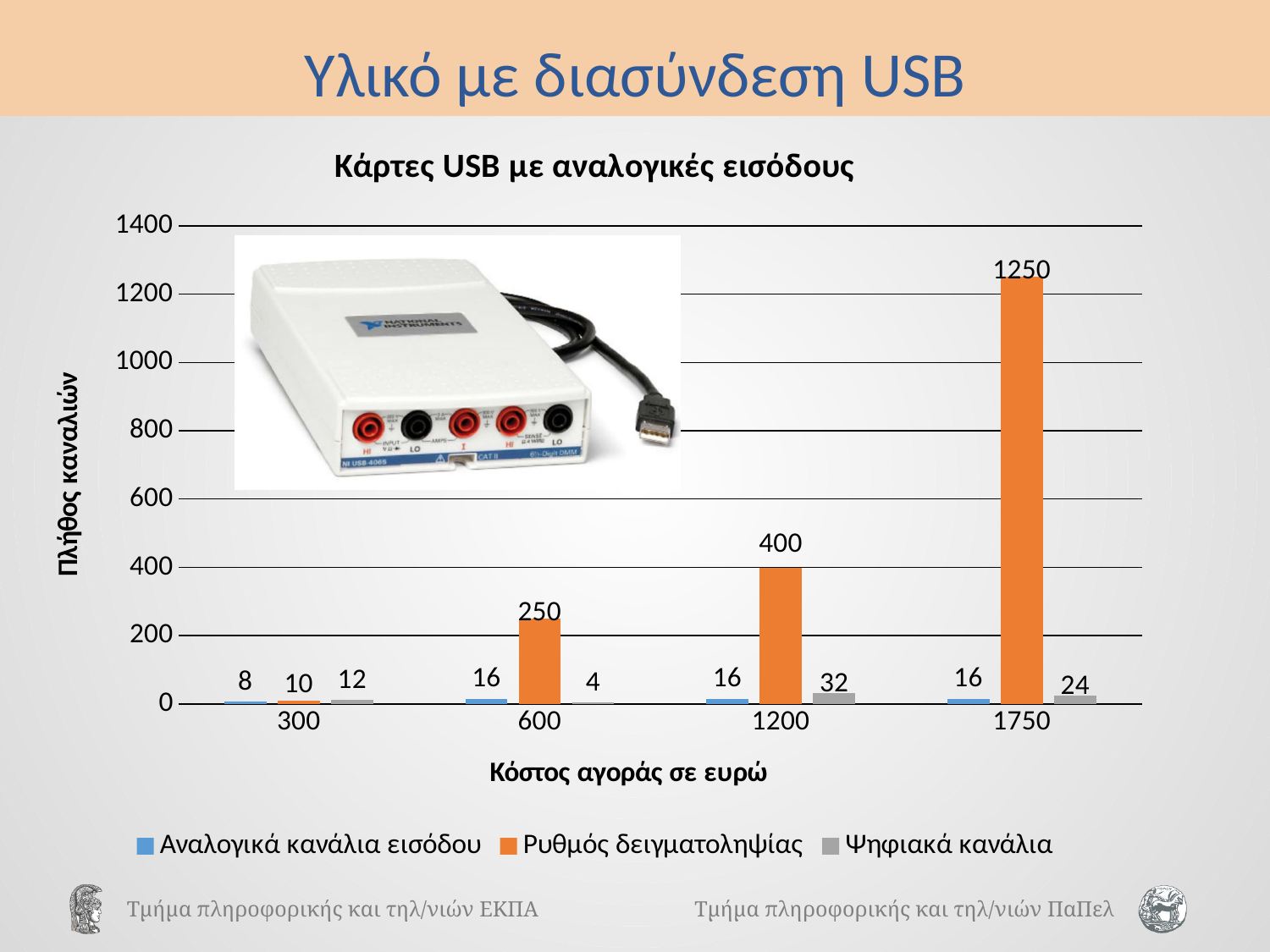
What is the value of Ψηφιακά κανάλια for the 1200 category? 32 Which is larger: Ψηφιακά κανάλια at 1750 or Ψηφιακά κανάλια at 1200? 1200 Which category has the lowest value for Ψηφιακά κανάλια? 600 How many series does the legend list? 3 What is the value of Ρυθμός δειγματοληψίας for the 1750 category? 1250 How many categories are shown on the x axis? 4 Does Ρυθμός δειγματοληψίας rise or fall as the cost increases along the x axis? rise What is the title of the chart? Κάρτες USB με αναλογικές εισόδους What is the difference between Ρυθμός δειγματοληψίας at 1200 and at 600? 150 What is the value of Αναλογικά κανάλια εισόδου for the 300 category? 8 Which category has the highest value for Ρυθμός δειγματοληψίας? 1750 What kind of chart is shown? bar chart